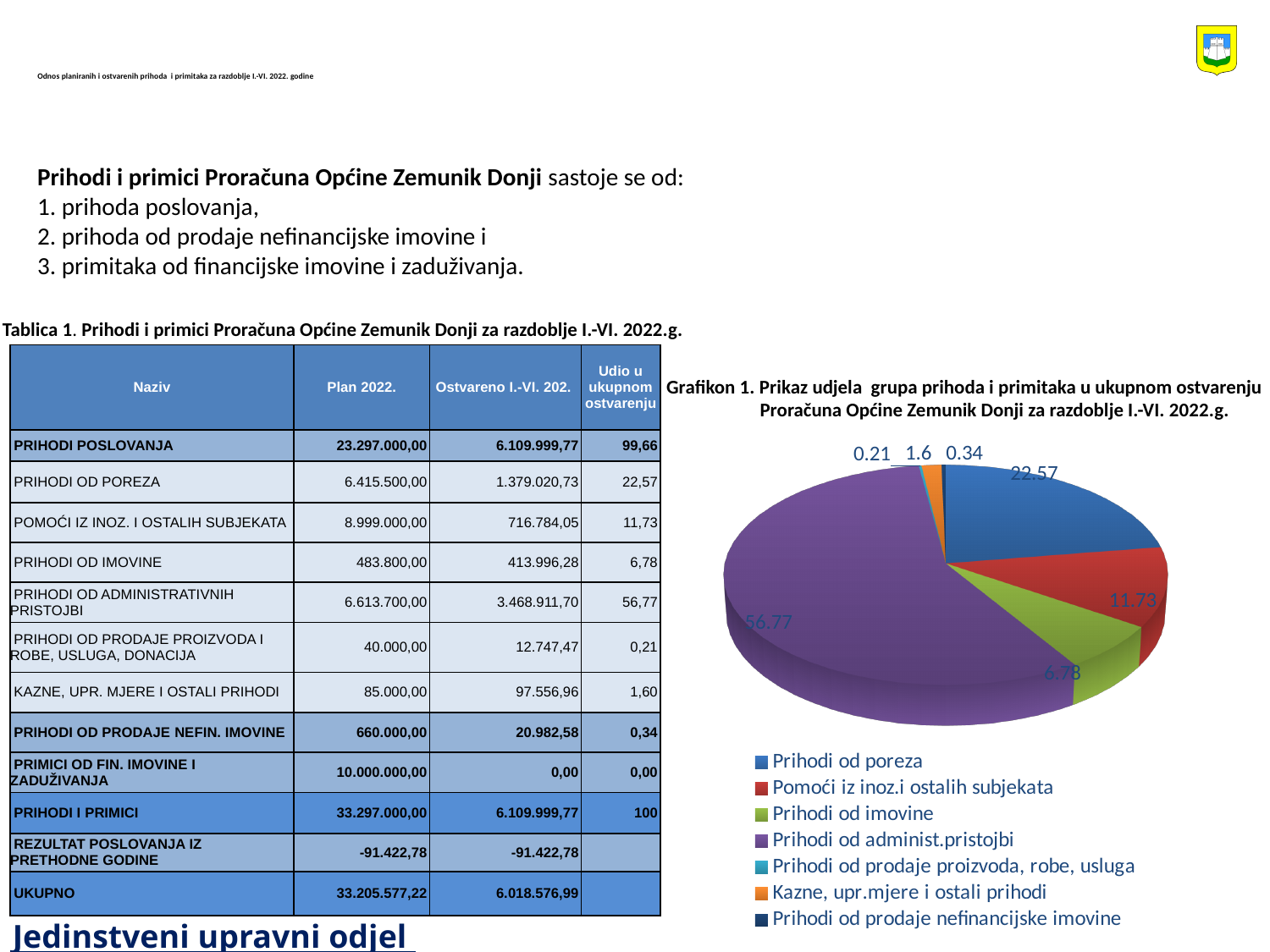
Which category has the smallest slice in the pie chart? Prihodi od prodaje proizvoda, robe, usluga What type of chart is shown on the slide? pie chart In the pie chart, what is the value shown for Prihodi od administ.pristojbi? 56.77 In the pie chart, what is the value shown for Prihodi od imovine? 6.78 In the pie chart, what is the value shown for Pomoći iz inoz.i ostalih subjekata? 11.73 Which category has the largest slice in the pie chart? Prihodi od administ.pristojbi What colour is the slice for Prihodi od administ.pristojbi in the pie chart? purple In the pie chart, what is the value shown for Kazne, upr.mjere i ostali prihodi? 1.6 In the pie chart, which is larger: Pomoći iz inoz.i ostalih subjekata or Prihodi od imovine? Pomoći iz inoz.i ostalih subjekata In the pie chart, what is the difference between the values for Prihodi od administ.pristojbi and Prihodi od poreza? 34.2 In the pie chart, what is the value shown for Prihodi od poreza? 22.57 How many categories does the legend of the pie chart list? 7